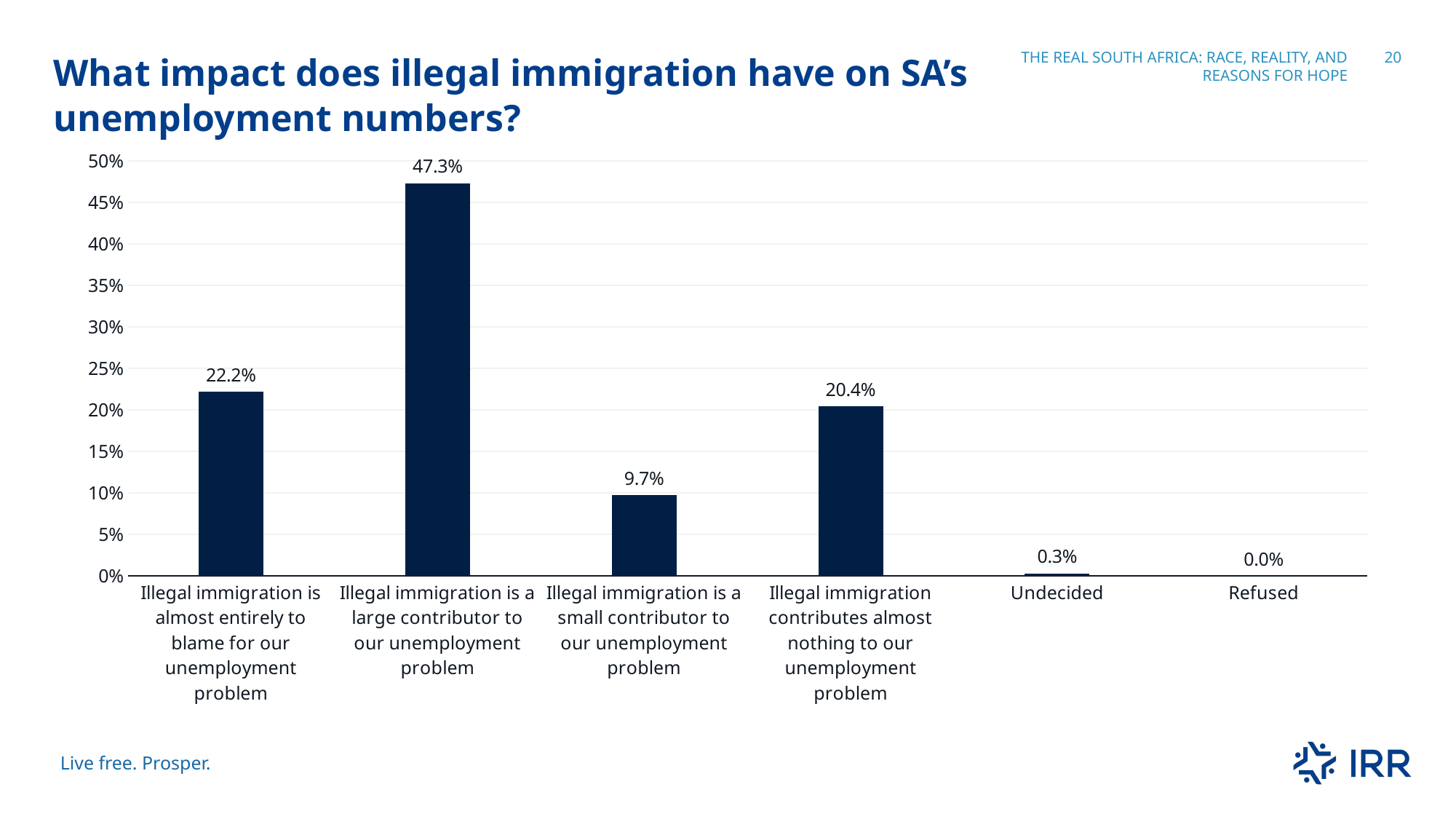
What is the title of the slide? What impact does illegal immigration have on SA's unemployment numbers? Which response category has the highest percentage? Illegal immigration is a large contributor to our unemployment problem What percentage of respondents said illegal immigration is a large contributor to our unemployment problem? 47.3% What type of chart is shown on the slide? Bar chart Which is larger: the percentage for 'Illegal immigration is almost entirely to blame for our unemployment problem' or for 'Illegal immigration contributes almost nothing to our unemployment problem'? Illegal immigration is almost entirely to blame for our unemployment problem How many response categories are shown on the x axis? 6 What is the difference in percentage points between 'Illegal immigration is a large contributor to our unemployment problem' and 'Illegal immigration is almost entirely to blame for our unemployment problem'? 25.1 percentage points Which response category has the lowest percentage? Refused What percentage of respondents said illegal immigration is a small contributor to our unemployment problem? 9.7% What percentage of respondents were undecided? 0.3% What percentage of respondents refused to answer? 0.0% What percentage of respondents said illegal immigration is almost entirely to blame for our unemployment problem? 22.2%